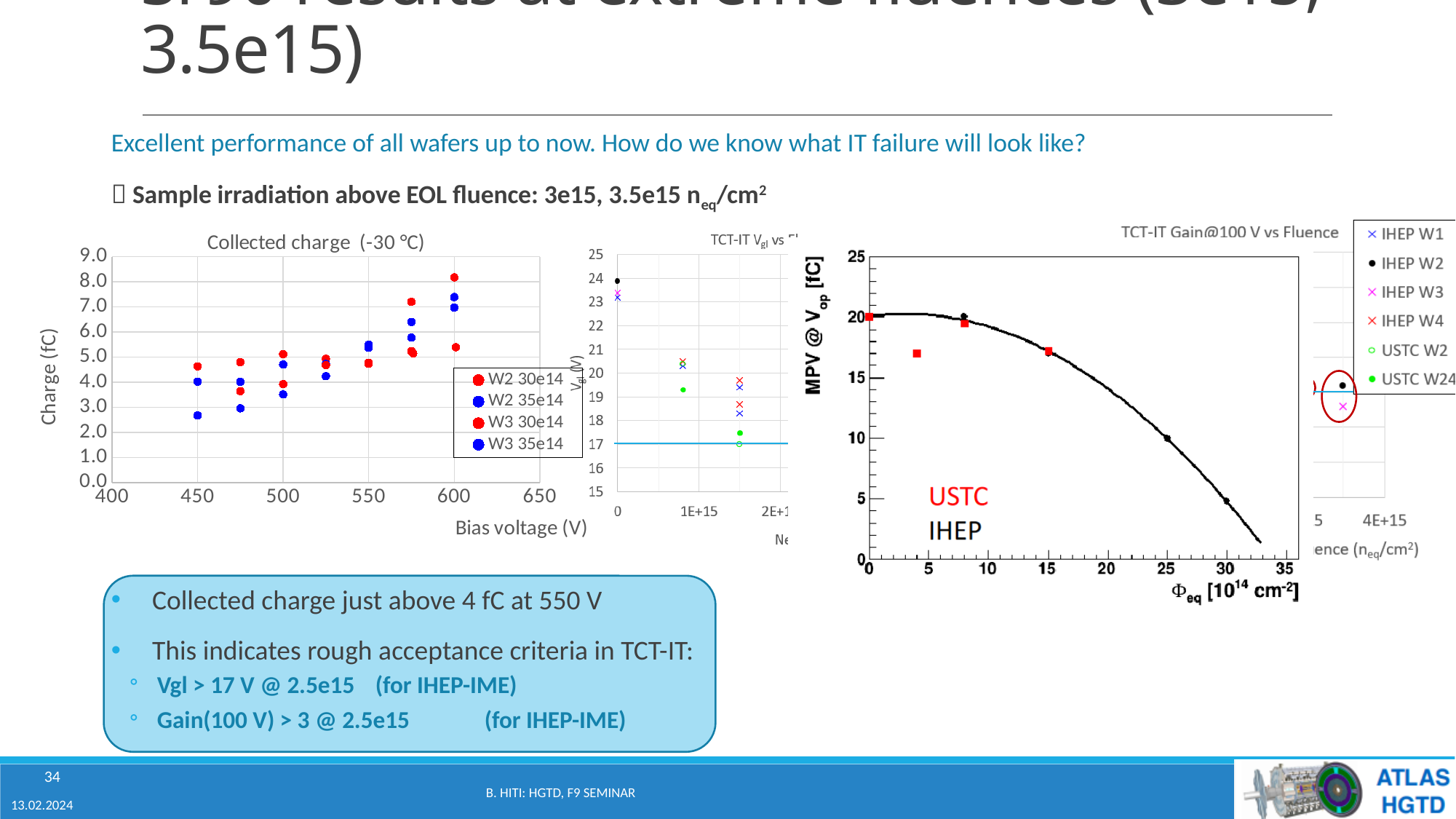
How many series does the legend of the 'Collected charge (-30 °C)' chart list? 4 In the 'Collected charge (-30 °C)' chart, at which bias voltage is the highest collected charge plotted? 600 V In the 'Collected charge (-30 °C)' chart, does the collected charge generally rise or fall as bias voltage increases? rise How many entries does the legend at the top right of the slide (IHEP W1, IHEP W2, ...) list? 6 In the 'Collected charge (-30 °C)' chart, is the lowest blue point at 450 V greater or less than 3.0 fC? less In the 'Collected charge (-30 °C)' chart, is the highest red point at 600 V greater or less than 8.0 fC? greater What kind of chart is the 'Collected charge (-30 °C)' chart? scatter chart In the 'TCT-IT Vgl vs Fluence' chart, at what value is the horizontal blue line drawn on the y axis? 17 In the 'Collected charge (-30 °C)' chart, what is the label of the y axis? Charge (fC) In the 'MPV @ Vop' vs fluence chart, does the MPV rise or fall as the fluence increases? fall In the 'Collected charge (-30 °C)' chart, what is the label of the x axis? Bias voltage (V) In the 'MPV @ Vop' vs fluence chart, is the red USTC point at a fluence of 4 greater or less than 15 fC? greater